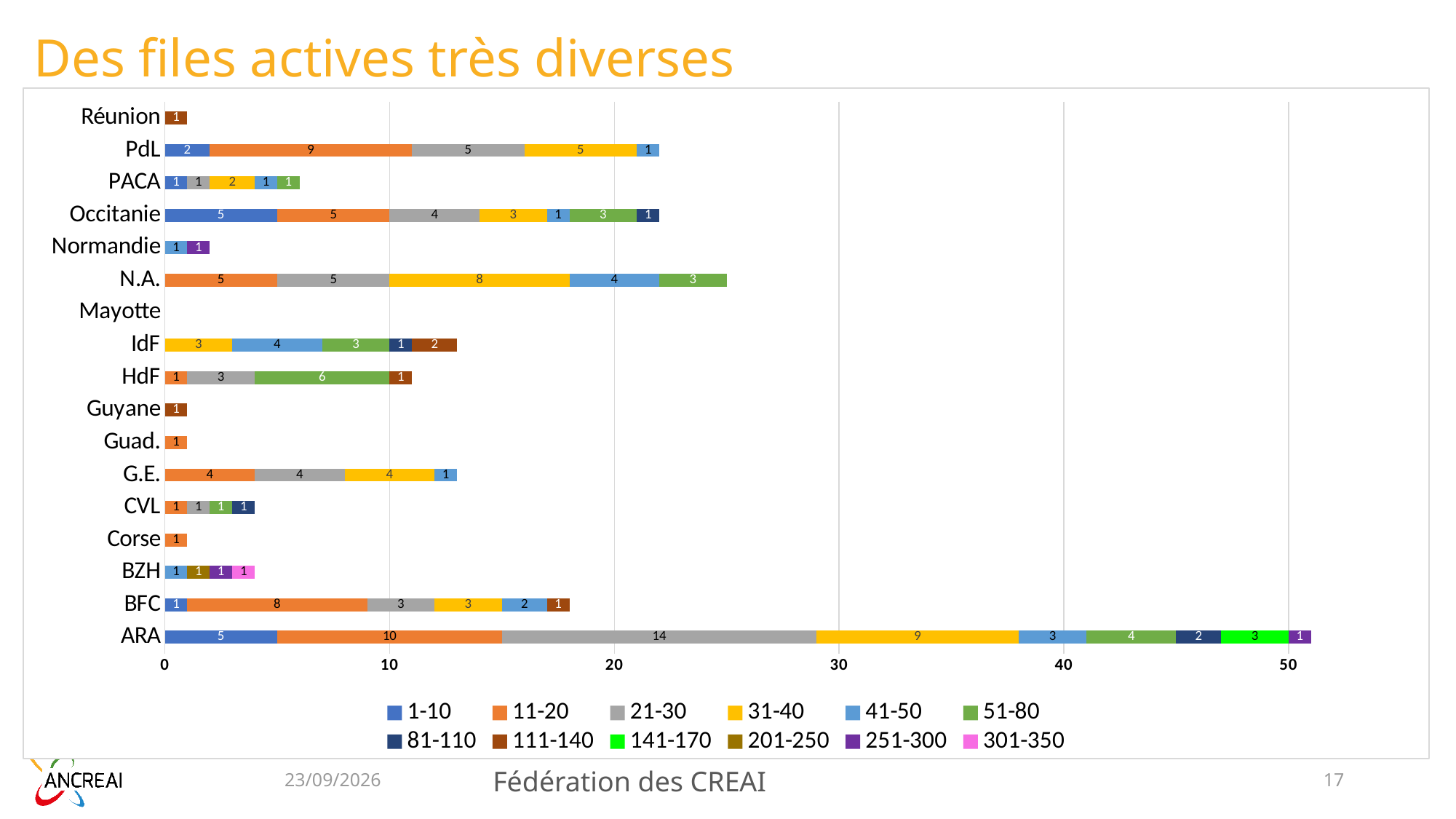
What is the total of the stacked bar for ARA? 51 What is the value of the 31-40 segment for N.A.? 8 Is the total bar length for N.A. greater or less than 20? greater What kind of chart is shown on the slide? stacked bar chart How many series does the legend list? 12 How many regions are listed on the vertical axis? 17 What is the value of the 51-80 segment for HdF? 6 Which region has the longest stacked bar? ARA What is the value of the 21-30 segment for ARA? 14 What is the total of the stacked bar for PdL? 22 Which region has the larger total bar, N.A. or BFC? N.A. What is the difference between the 11-20 segment for ARA and the 11-20 segment for PdL? 1